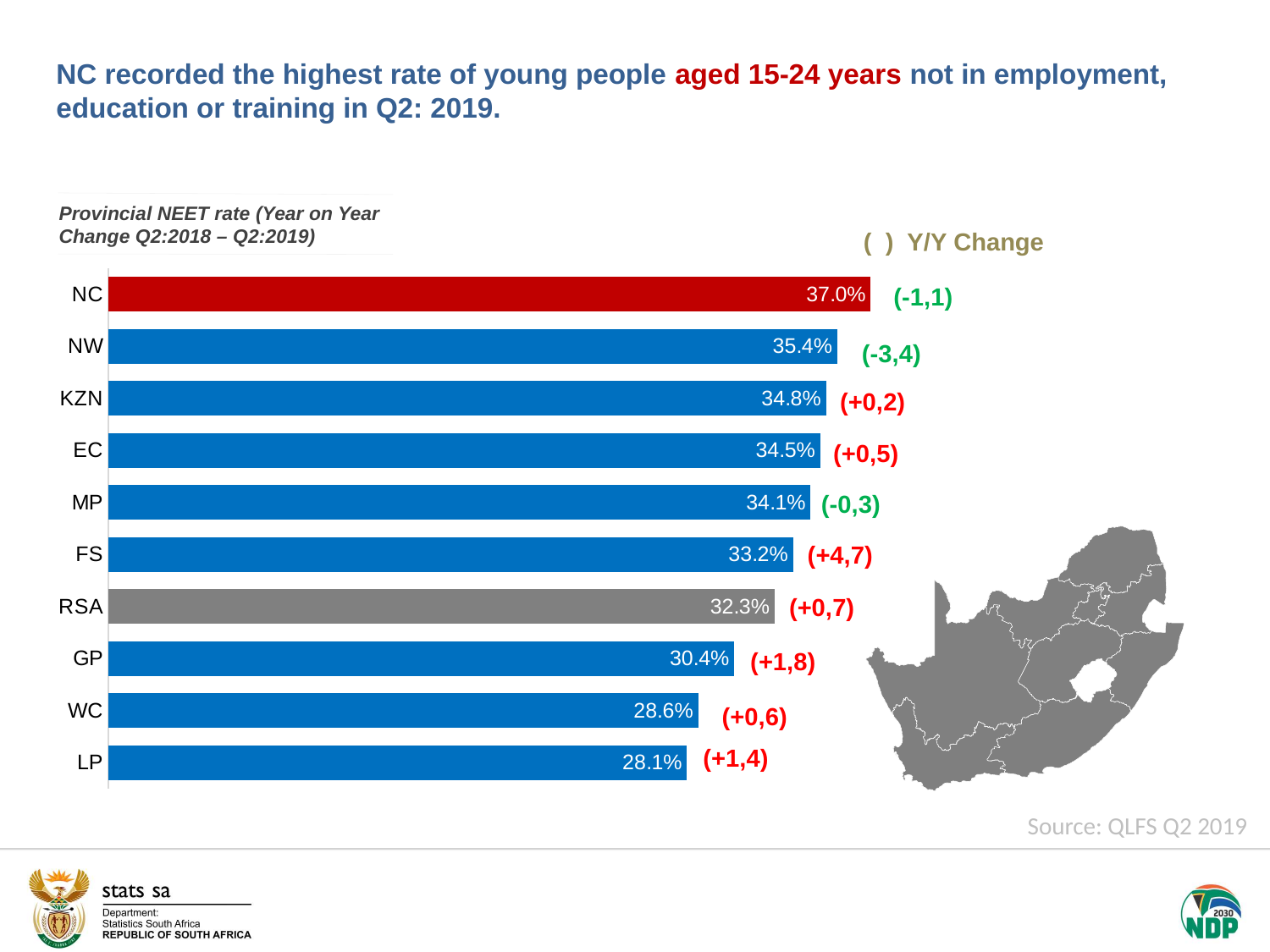
Which bar is coloured red in the chart? NC Which province has the highest NEET rate? NC What is the difference between the NEET rates of GP and WC? 1.8% What is the year-on-year change shown in brackets for FS? (+4,7) What is the NEET rate for LP? 28.1% Which has a higher NEET rate, FS or GP? FS Which category has the lowest NEET rate? LP What is the difference between the NEET rates of NC and NW? 1.6% How many categories are shown in the bar chart? 10 What kind of chart is shown on the slide? Bar chart What is the NEET rate for RSA? 32.3% What is the NEET rate for NC? 37.0%